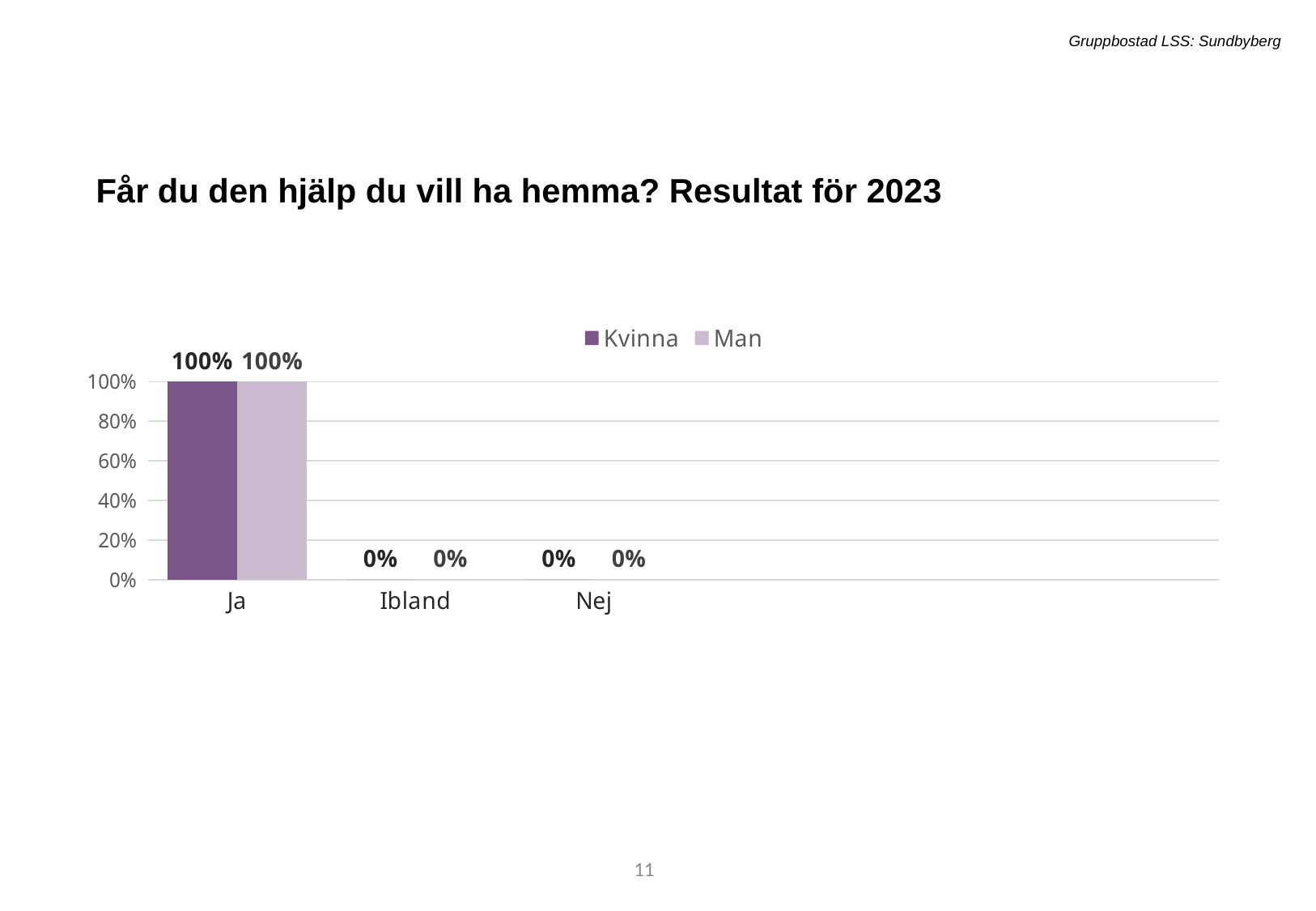
How many categories are shown on the x axis? 3 How many series does the legend list? 2 What is the title of the chart? Får du den hjälp du vill ha hemma? Resultat för 2023 Which category has the highest value for Kvinna? Ja What kind of chart is shown on the slide? Bar chart What is the value for Man in the Ja category? 100% Which is larger: the Man value for Ja or the Man value for Ibland? Ja What is the value for Man in the Nej category? 0% What is the difference between the Kvinna value for Ja and the Kvinna value for Nej? 100% What is the value for Kvinna in the Ja category? 100% What is the value for Kvinna in the Ibland category? 0% What are the two series named in the legend? Kvinna and Man